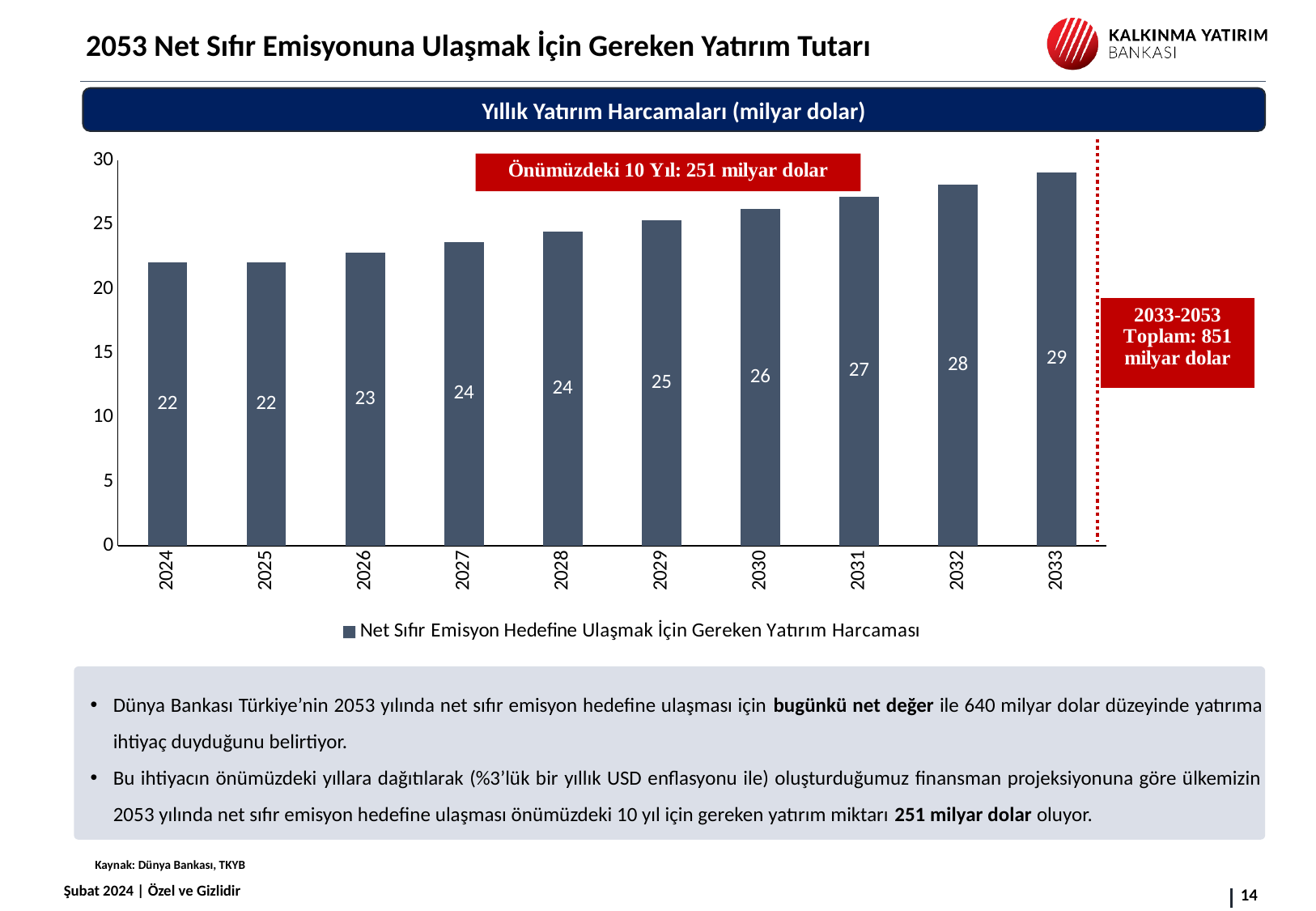
What is the difference between the values for 2033 and 2024? 7 What kind of chart is shown? bar chart What is the value for 2033? 29 What is the value for 2031? 27 Which is larger, the value for 2032 or the value for 2029? 2032 What is the value for 2026? 23 Is the value for 2030 greater or less than 25? greater How many years are shown on the x axis? 10 How many series does the legend list? 1 Do the values rise or fall from 2024 to 2033? rise Which year has the highest value? 2033 What is the difference between the values for 2030 and 2026? 3